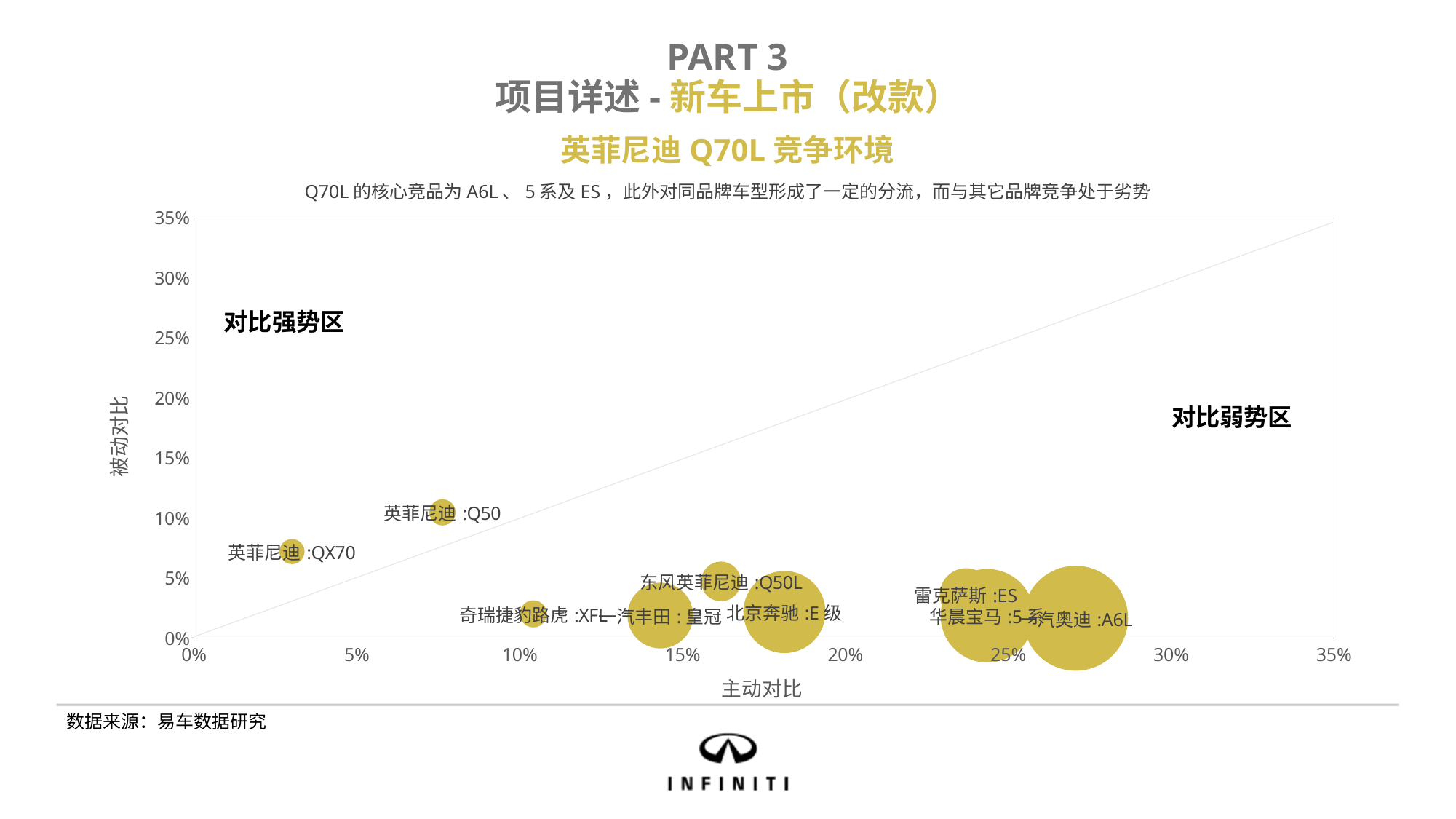
Is the 被动对比 value for 英菲尼迪:Q50 greater or less than 5%? greater Is the 主动对比 value for 一汽奥迪:A6L greater or less than 25%? greater Which car model has the highest 被动对比 value on the chart? 英菲尼迪:Q50 Is the 主动对比 value for 英菲尼迪:QX70 greater or less than 5%? less What is the label of the x axis? 主动对比 Which has a higher 被动对比 value, 英菲尼迪:Q50 or 一汽丰田:皇冠? 英菲尼迪:Q50 Which car model has the highest 主动对比 value on the chart? 一汽奥迪:A6L What kind of chart is shown on the slide? Bubble chart How many bubbles (car models) are plotted on the chart? 9 Which car model has the lowest 主动对比 value on the chart? 英菲尼迪:QX70 What is the title of the chart? 英菲尼迪 Q70L 竞争环境